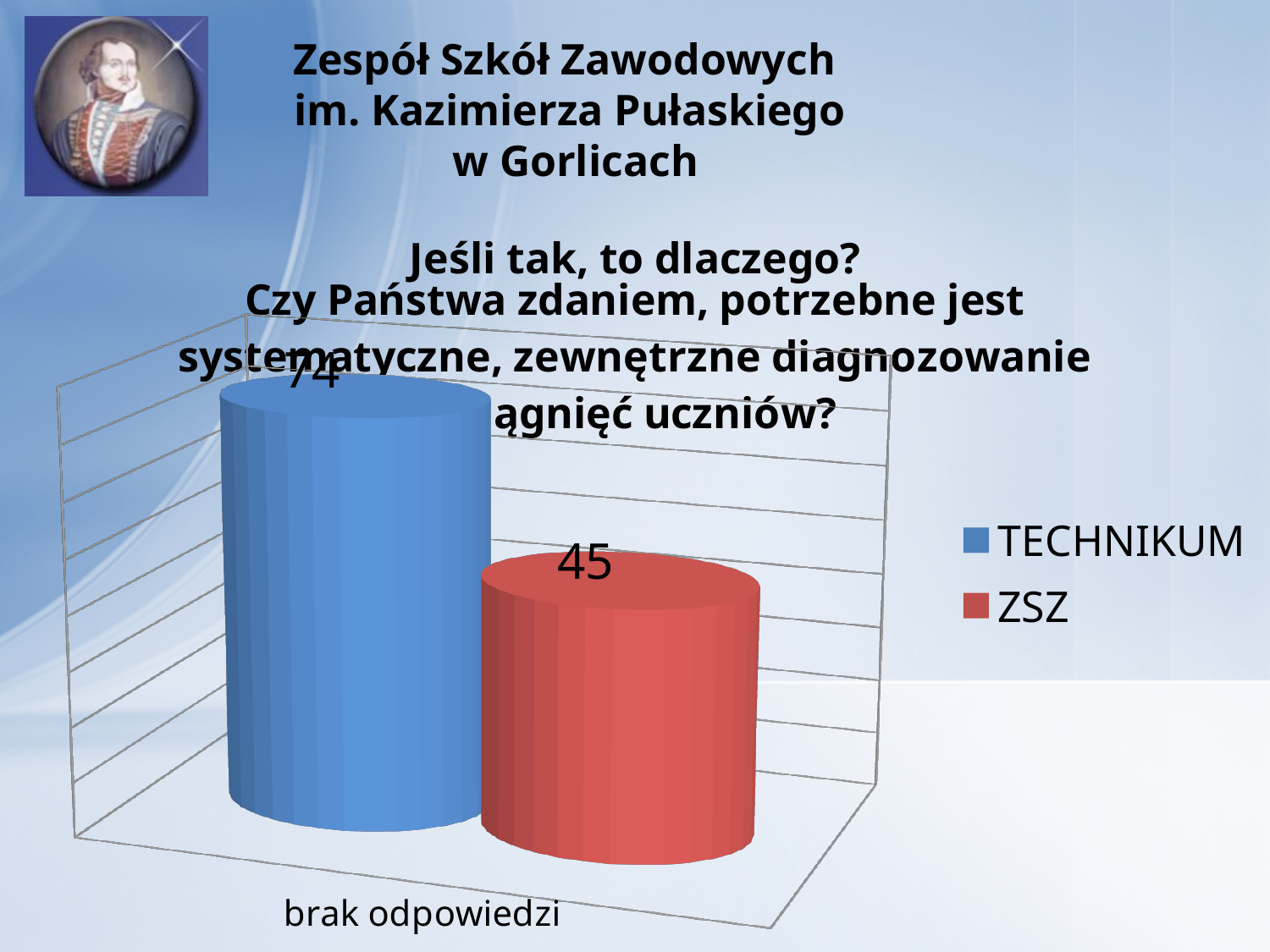
Which series has the lowest value in the chart? ZSZ How many categories are shown on the x axis of the chart? 1 How many series does the legend list? 2 Which series has the higher value, TECHNIKUM or ZSZ? TECHNIKUM What kind of chart is shown on the slide? Bar chart What is the value for ZSZ in the chart? 45 What is the difference between the TECHNIKUM value and the ZSZ value? 29 What is the category label shown on the x axis of the chart? brak odpowiedzi Which series has the highest value in the chart? TECHNIKUM What colour is the bar for ZSZ? Red What is the value for TECHNIKUM in the chart? 74